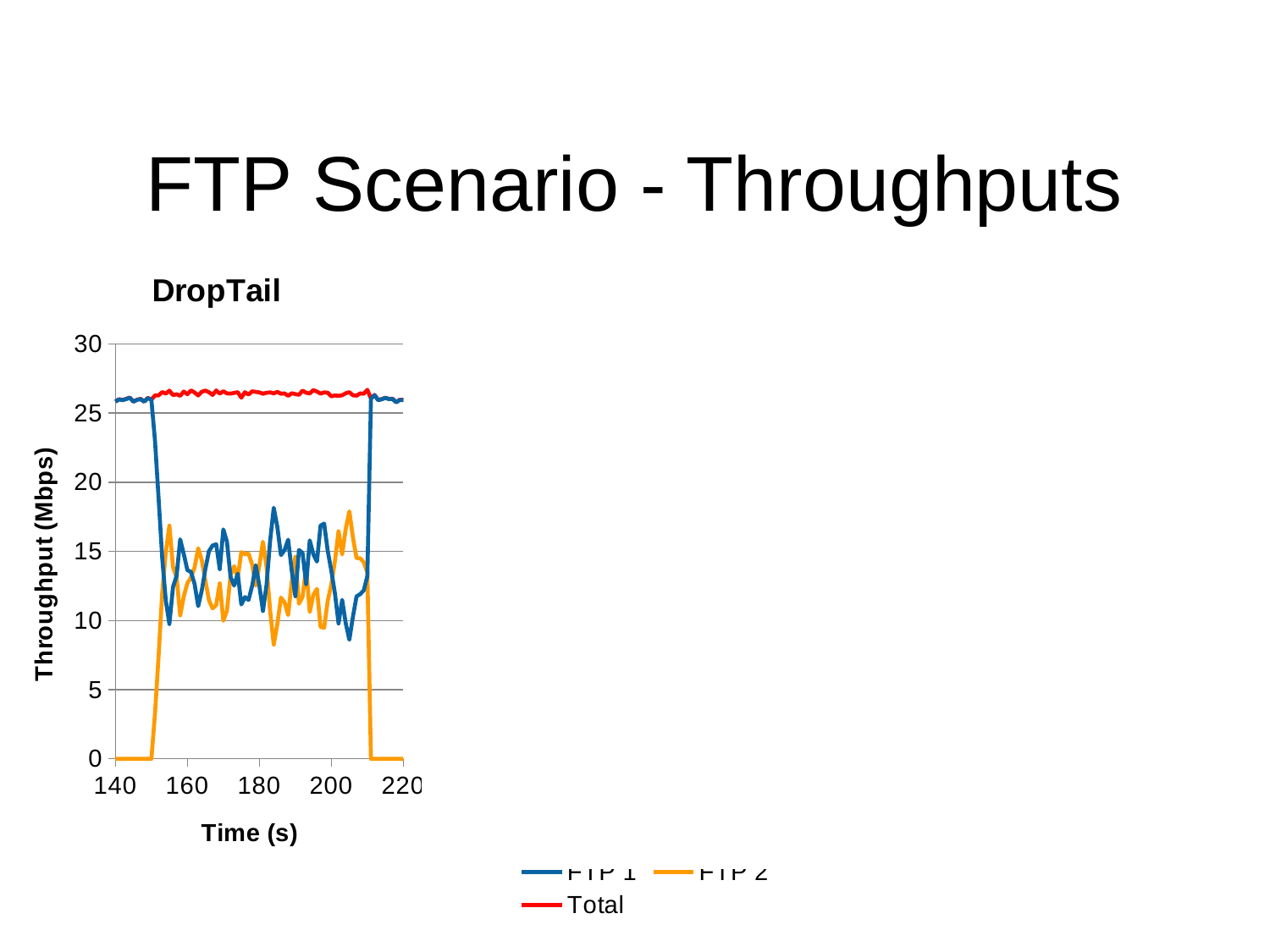
What kind of chart is shown on the slide? line chart In the DropTail chart, is the value for Total at 180 s greater or less than 25? greater In the DropTail chart, which series has the larger value at 180 s, Total or FTP 1? Total In the DropTail chart, is the value for FTP 1 at 140 s greater or less than 25? greater In the DropTail chart, is the value for FTP 2 at 145 s greater or less than 5? less What is the y-axis title of the DropTail chart? Throughput (Mbps) How many series does the legend of the DropTail chart list? 3 In the DropTail chart, does the FTP 2 series rise or fall between 150 s and 155 s? rise What is the title of the chart on the slide? DropTail In the DropTail chart, which series has the larger value at 140 s, FTP 1 or FTP 2? FTP 1